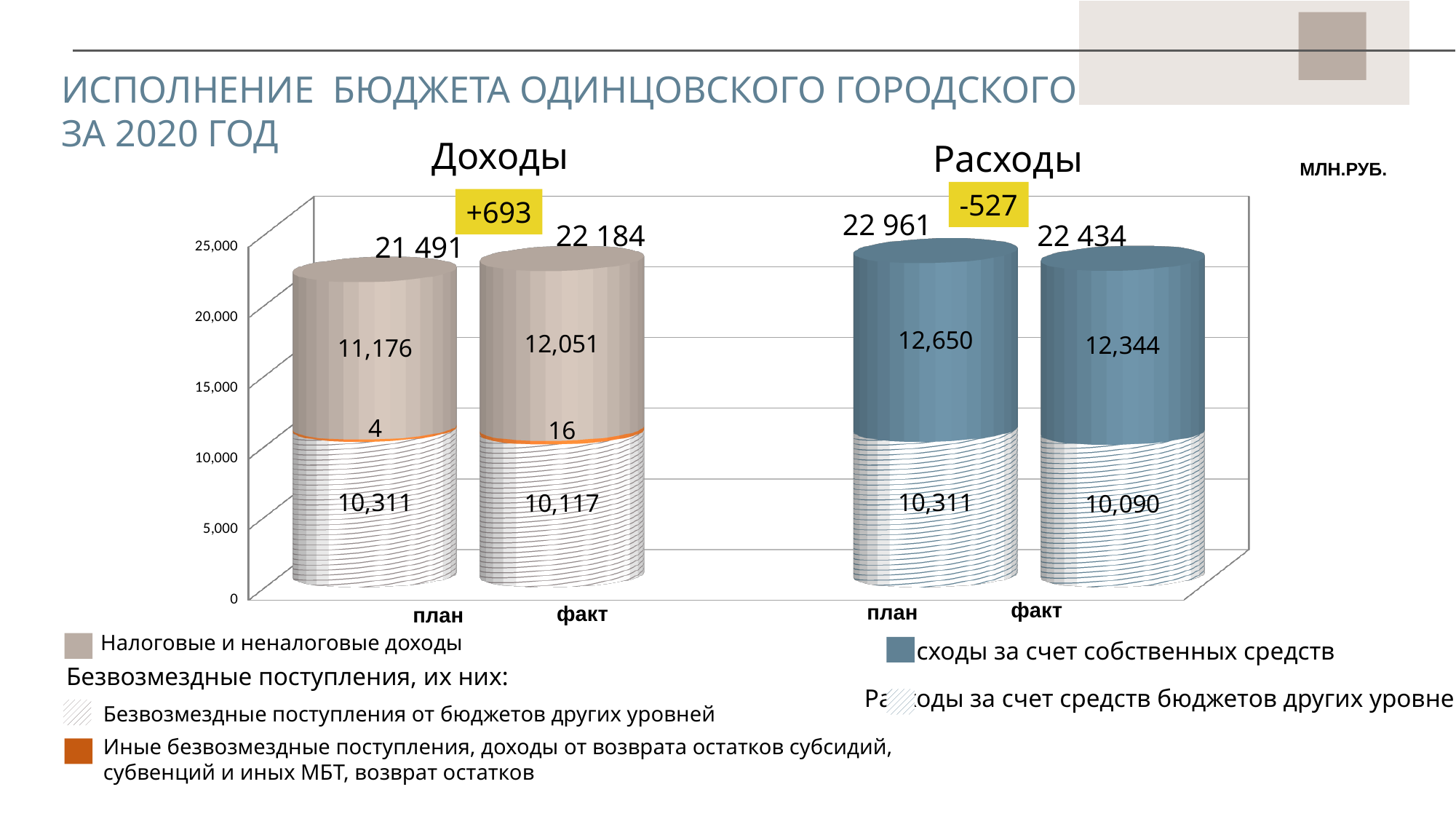
What is the total shown above the Расходы план bar? 22 961 What is the value of Налоговые и неналоговые доходы for the Доходы факт bar? 12,051 What is the value of Налоговые и неналоговые доходы for the Доходы план bar? 11,176 What is the total shown above the Доходы факт bar? 22 184 Which is larger: Расходы за счет собственных средств for план or for факт? план What kind of chart is shown on the slide? stacked bar chart How many bars are plotted on the chart? 4 What is the difference between the Доходы факт total and the Доходы план total, as labelled on the chart? +693 What is the value of Безвозмездные поступления от бюджетов других уровней for the Доходы план bar? 10,311 What is the value of Иные безвозмездные поступления for the Доходы факт bar? 16 What is the difference between the Расходы факт total and the Расходы план total, as labelled on the chart? -527 What is the value of Расходы за счет собственных средств for the Расходы факт bar? 12,344